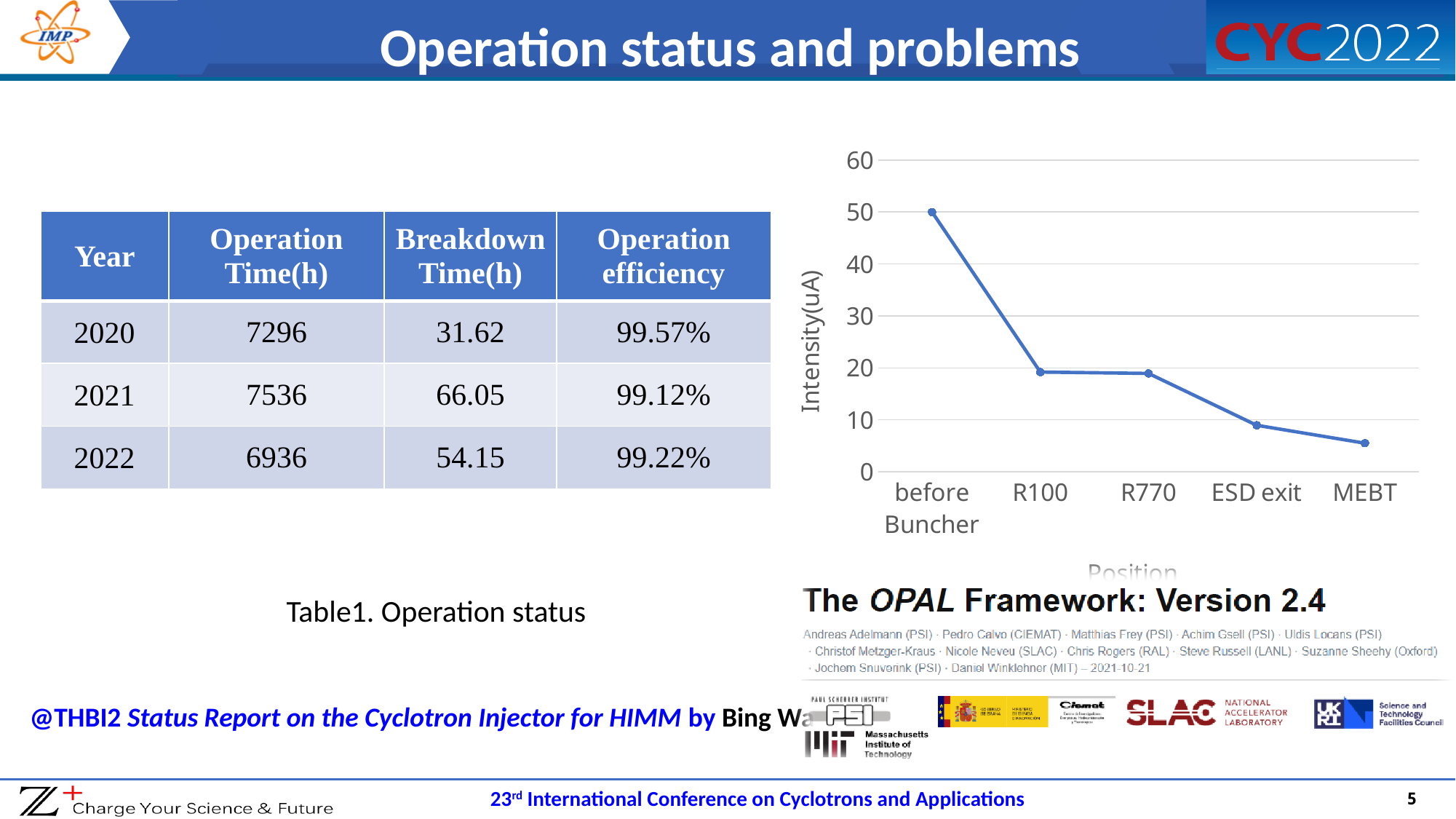
How many positions are plotted along the x axis of the line chart? 5 Does the intensity rise or fall from before Buncher to MEBT along the x axis? fall Which position has the highest intensity in the line chart? before Buncher Is the intensity at R770 greater or less than 10? greater What kind of chart is shown on the right of the slide? line chart What is the label of the y axis of the line chart? Intensity(uA) Is the intensity at R100 greater or less than 30? less Is the intensity at MEBT greater or less than 10? less Which has the larger intensity, ESD exit or MEBT? ESD exit Which position has the lowest intensity in the line chart? MEBT